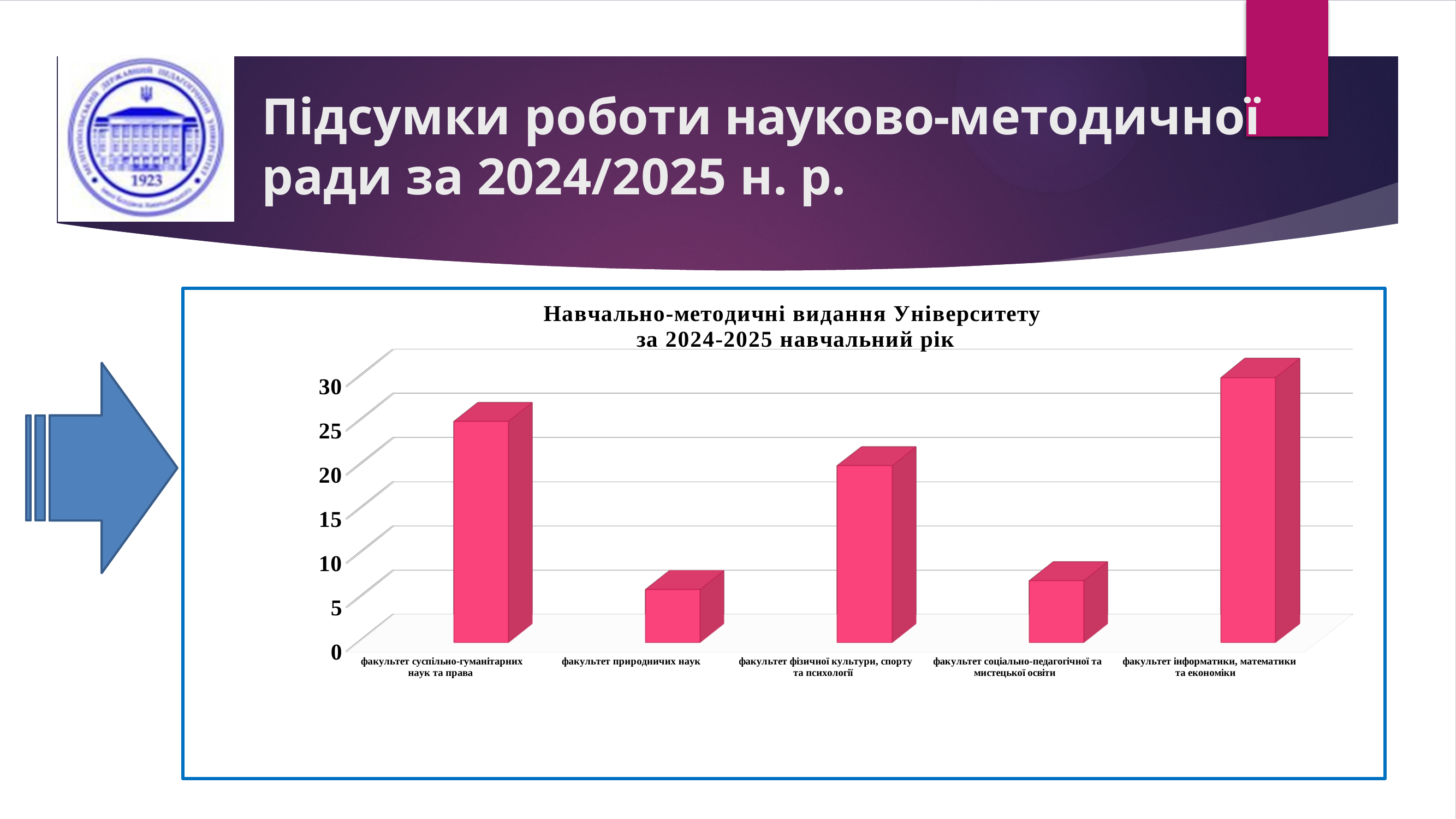
Is the value for факультет суспільно-гуманітарних наук та права greater or less than 20? greater Which faculty has the highest number of навчально-методичні видання? факультет інформатики, математики та економіки What is the title of the chart? Навчально-методичні видання Університету за 2024-2025 навчальний рік Which has a larger value: факультет природничих наук or факультет фізичної культури, спорту та психології? факультет фізичної культури, спорту та психології Is the value for факультет інформатики, математики та економіки greater or less than 25? greater What is the highest value shown on the chart's vertical axis? 30 Is the value for факультет соціально-педагогічної та мистецької освіти greater or less than 10? less How many faculties are shown on the x axis of the chart? 5 Which has a larger value: факультет суспільно-гуманітарних наук та права or факультет фізичної культури, спорту та психології? факультет суспільно-гуманітарних наук та права What kind of chart is shown on the slide? bar chart